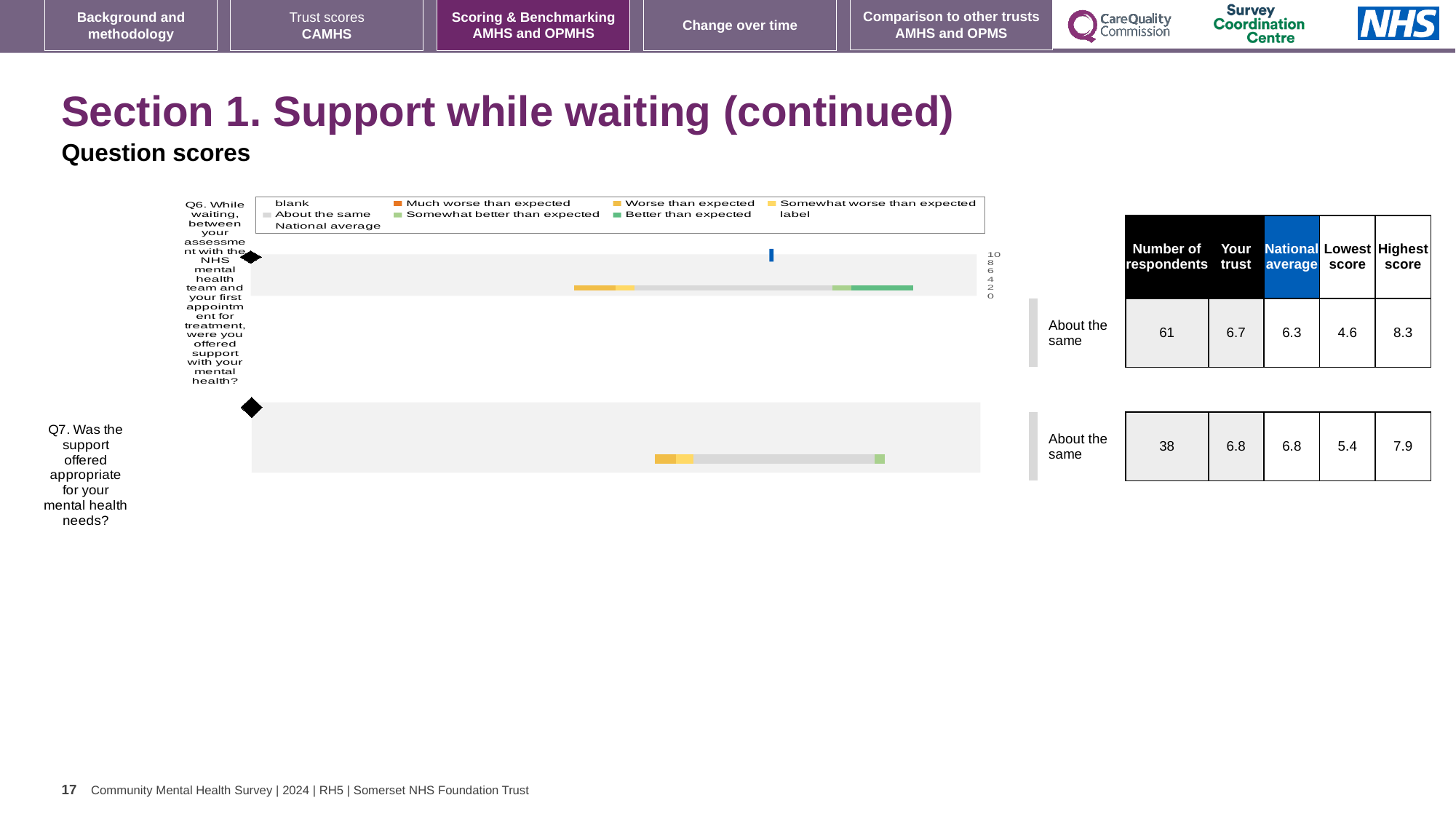
For Q6, what is the difference between the highest score and the lowest score? 3.7 In the chart legend, what colour represents 'Much worse than expected'? orange How many questions (bars) are plotted on the slide? 2 In the chart legend, what colour represents 'Better than expected'? green For Q6, which is larger: the 'Your trust' score or the national average? Your trust What is the lowest score listed for Q7? 5.4 What is the 'Your trust' score for Q6? 6.7 What is the national average score for Q7? 6.8 How many respondents are listed for Q6? 61 What kind of chart is used to show the Q6 and Q7 question scores? bar chart What benchmark category is shown next to the Q7 bar? About the same Which question has more respondents, Q6 or Q7? Q6